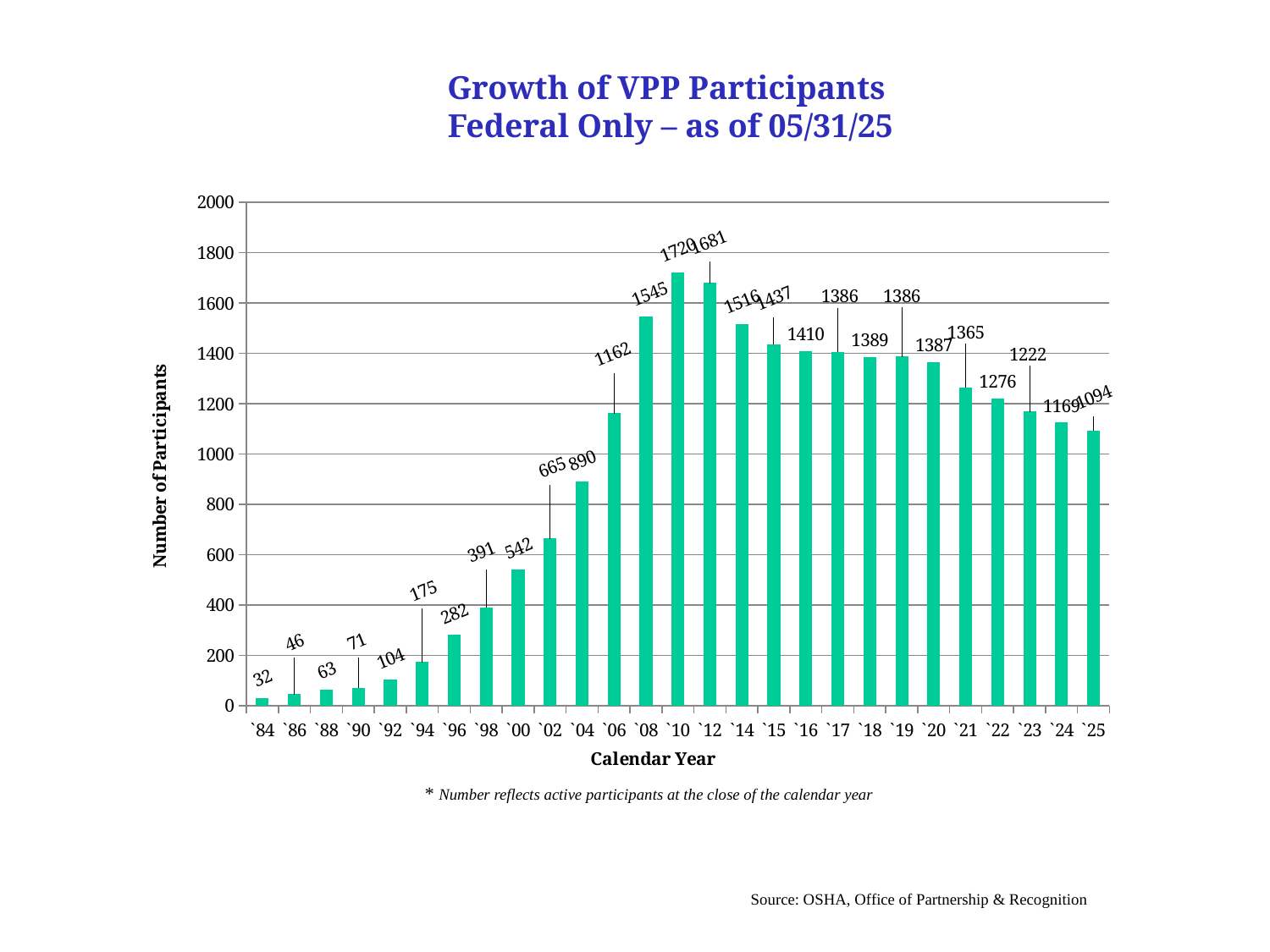
What is the number of participants for `10? 1720 How many calendar years are shown on the x axis? 27 Which calendar year has the lowest number of participants? `84 What is the difference between the number of participants in `10 and in `84? 1688 Which calendar year has the highest number of participants? `10 What is the number of participants for `04? 890 Which year has more participants, `06 or `08? `08 What is the number of participants for `84? 32 What is the label on the y axis? Number of Participants What is the number of participants for `08? 1545 Is the value for `12 greater or less than 1600? greater What type of chart is shown on the slide? Bar chart